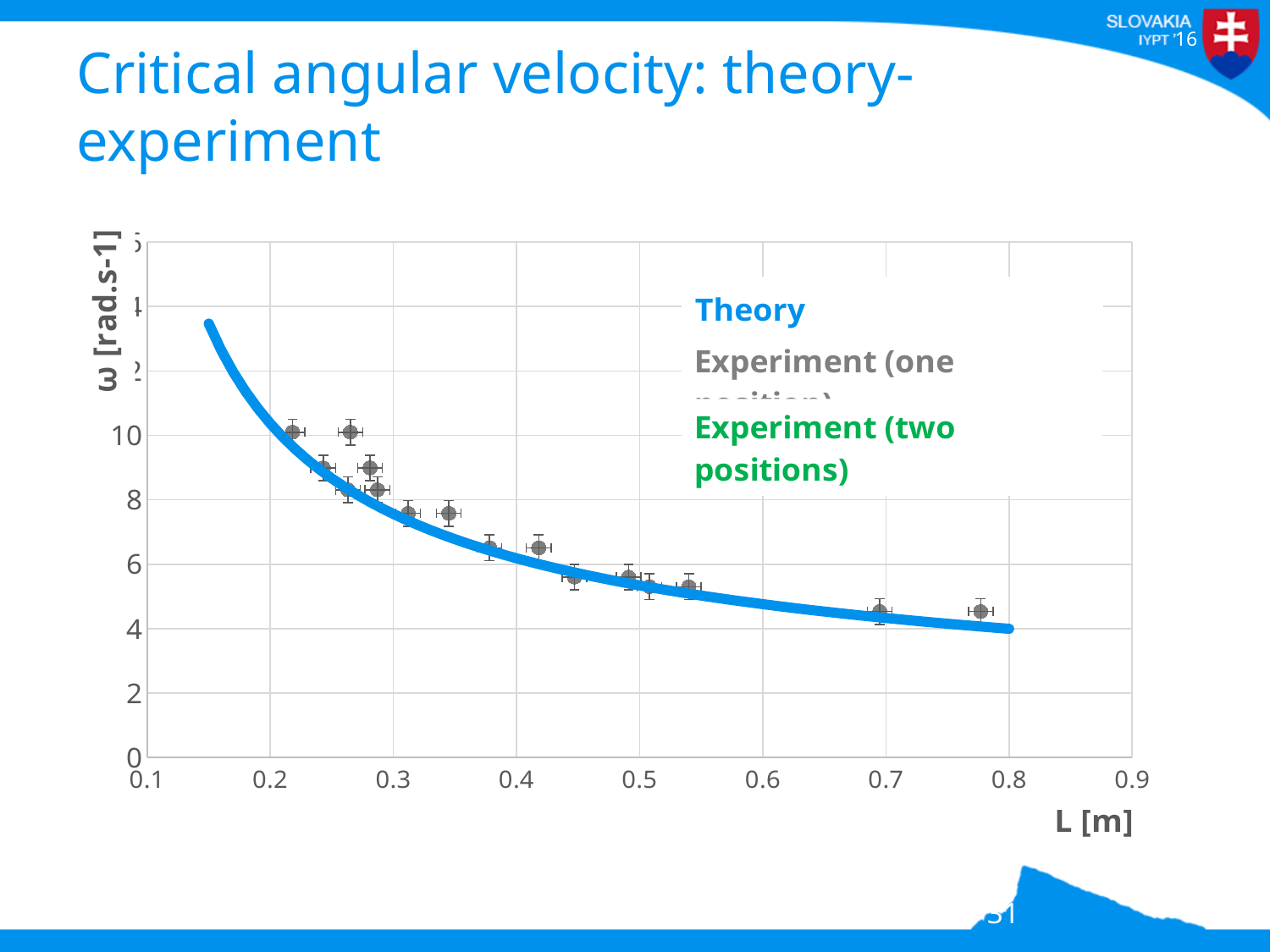
Is the value of the Theory curve at L = 0.7 m greater or less than 6? less What kind of chart is shown on the slide? Scatter chart with a fitted line Which series is drawn as a blue line? Theory Is the value of the Theory curve at L = 0.2 m greater or less than 8? greater Is the experimental point near L = 0.35 m greater or less than 6? greater How many series does the legend list? 3 Do the values of ω rise or fall as L increases along the x axis? Fall What is the label of the x axis? L [m]